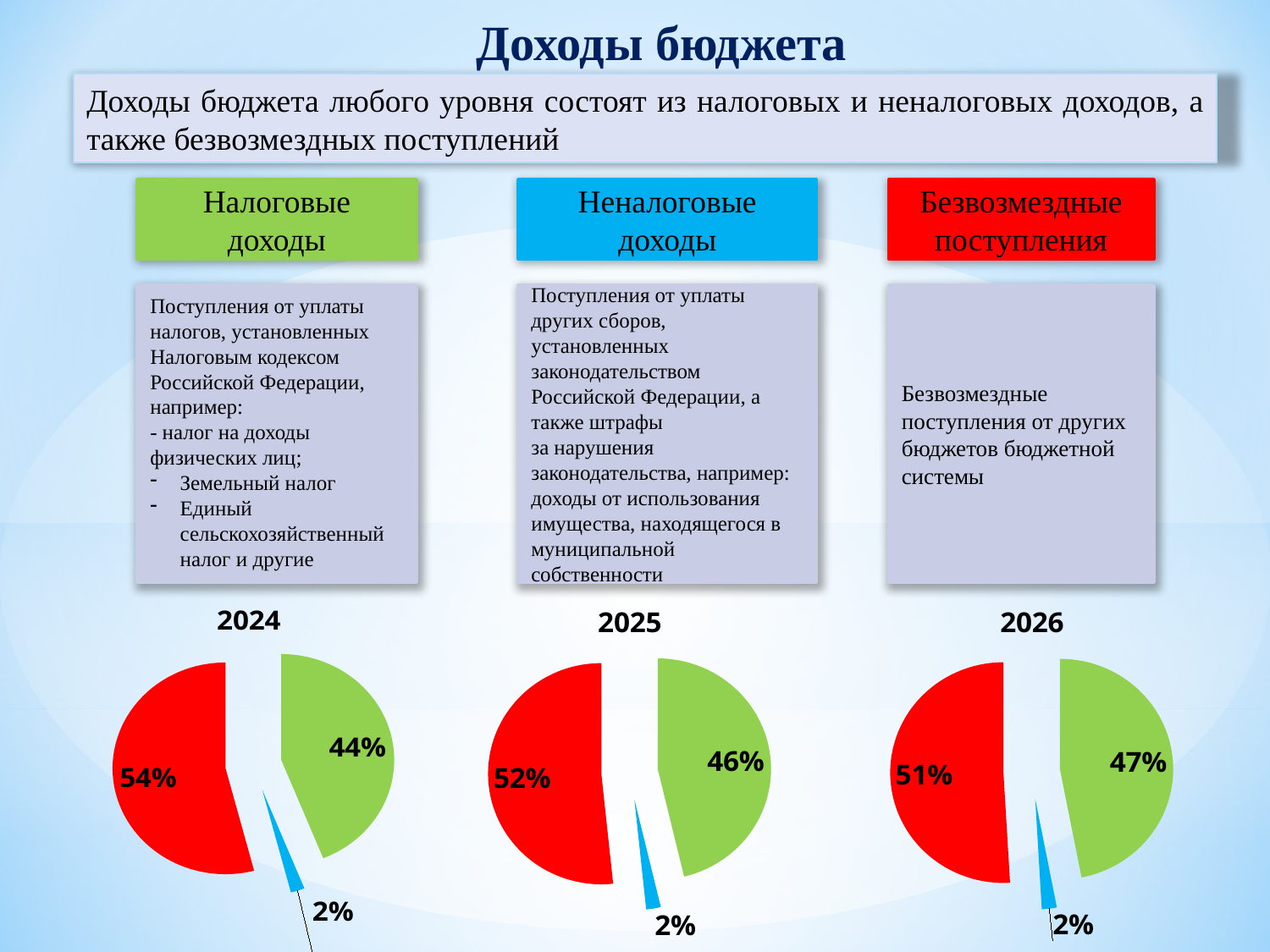
In the 2025 pie chart, what share does the green slice (Налоговые доходы) have? 46% In the 2026 pie chart, what share does the blue slice (Неналоговые доходы) have? 2% Across the 2024, 2025 and 2026 pie charts, does the green slice (Налоговые доходы) rise or fall over the years? rise In the 2024 pie chart, what share does the red slice (Безвозмездные поступления) have? 54% How many slices does each pie chart have? 3 In the 2024 pie chart, what is the difference between the red slice (54%) and the green slice (44%)? 10% In the 2025 pie chart, which slice is the largest? red (Безвозмездные поступления), 52% What kind of chart is used for 2024, 2025 and 2026? pie chart In the 2026 pie chart, which is larger: the green slice or the red slice? red (51%) In the 2024 pie chart, which slice is the smallest? blue (Неналоговые доходы), 2%